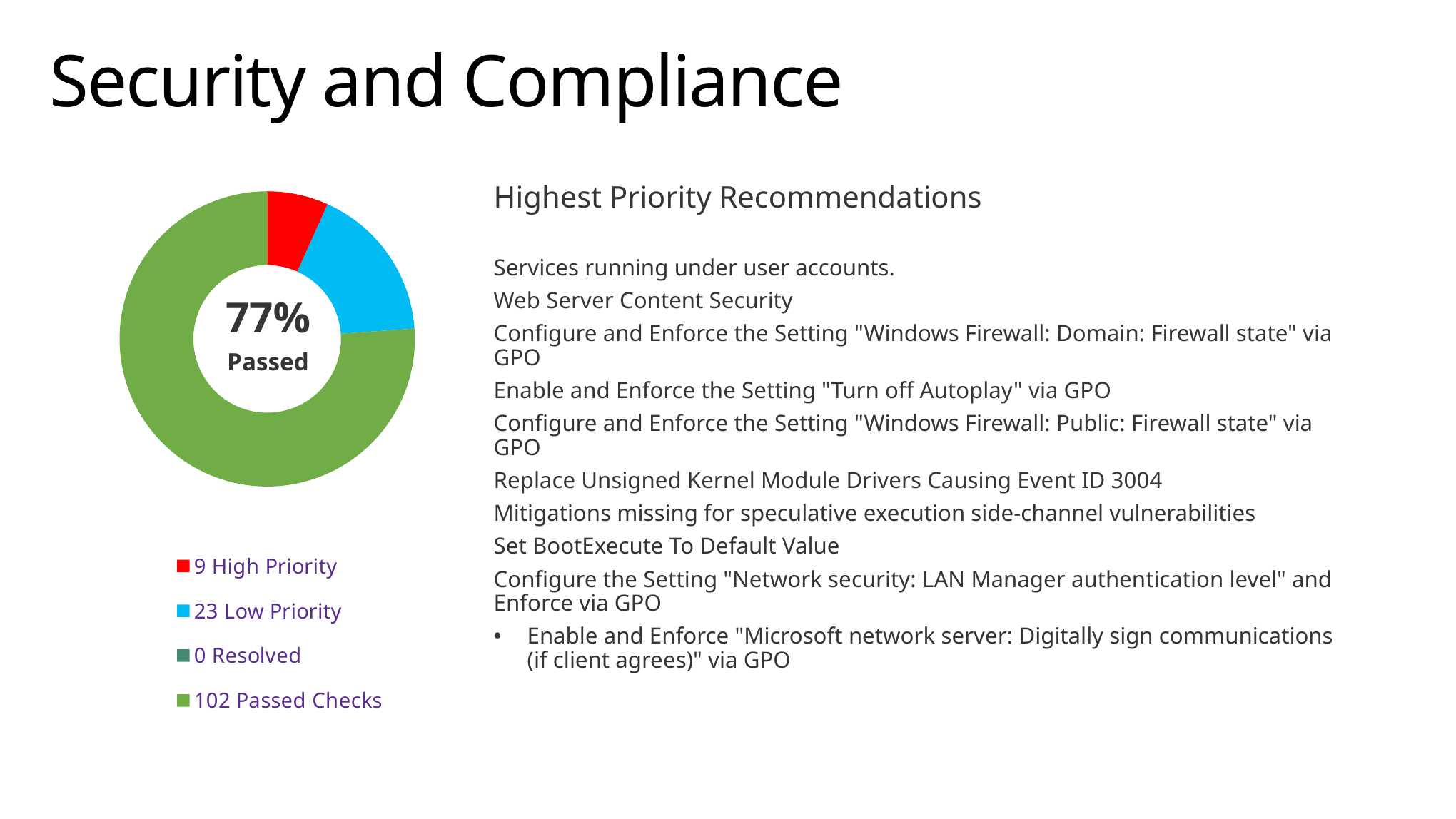
What kind of chart is shown on the slide? Donut (pie) chart Which category has the smallest value in the chart? Resolved How many categories are listed in the chart legend? 4 What is the difference between the Passed Checks and Low Priority counts? 79 What is the difference between the Low Priority and High Priority counts? 14 Which category has the largest value in the chart? Passed Checks What percentage is displayed in the centre of the donut chart? 77% How many Low Priority items does the chart legend show? 23 How many Passed Checks does the chart legend show? 102 Which is larger, the High Priority count or the Low Priority count? Low Priority How many High Priority items does the chart legend show? 9 How many Resolved items does the chart legend show? 0